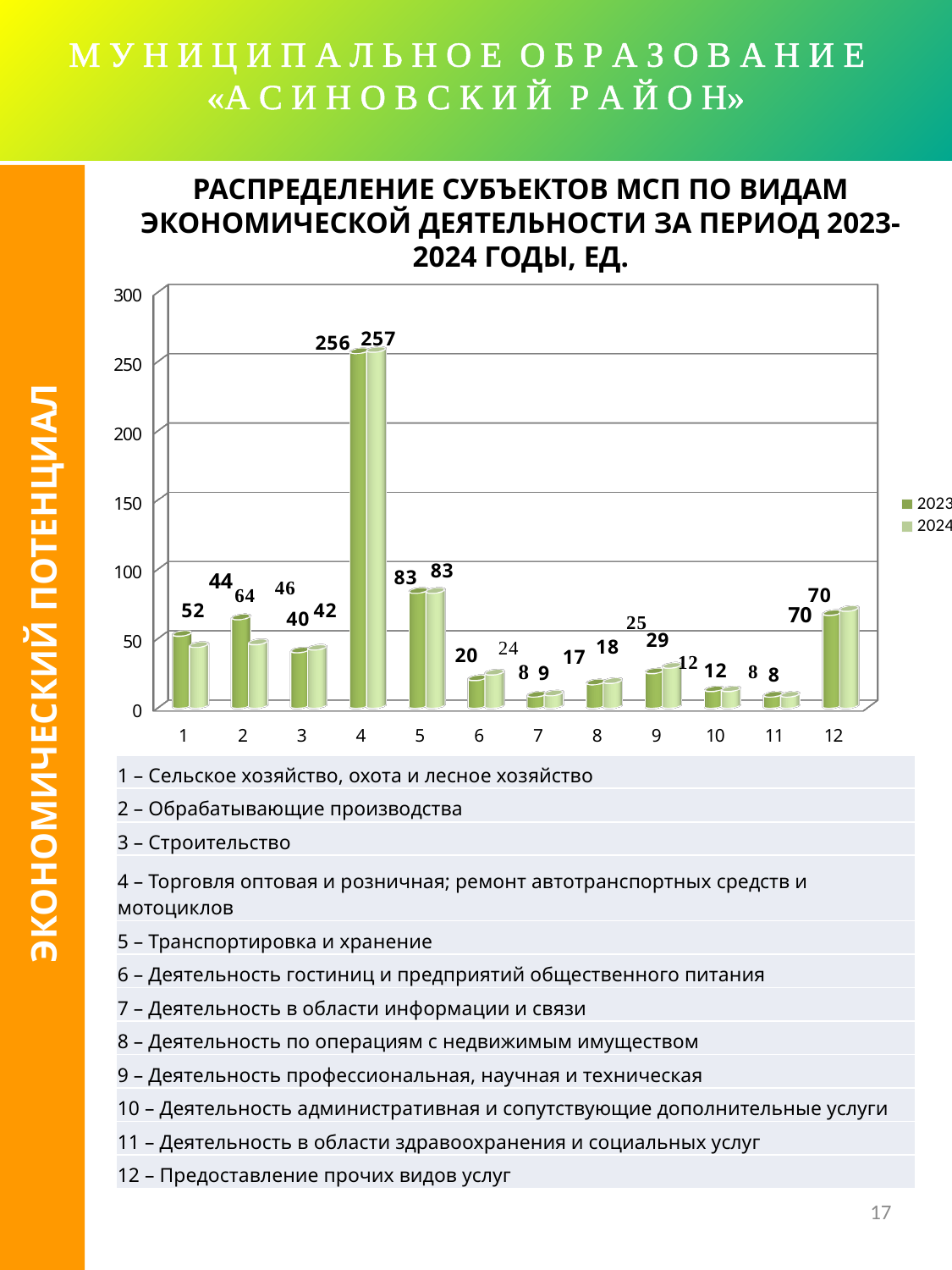
What is the value for category 5 in the 2024 series? 83 What is the difference between the 2024 and 2023 values for category 6? 4 What is the value for category 12 in the 2023 series? 70 What is the value for category 4 in the 2024 series? 257 Is the 2023 value for category 4 greater or less than 250? greater What kind of chart is shown on the slide? bar chart Which is larger in the 2023 series: the value for category 4 or the value for category 5? category 4 What is the value for category 6 in the 2024 series? 24 Which category has the highest value in the 2024 series? 4 What is the value for category 4 in the 2023 series? 256 How many series does the legend list? 2 How many categories are shown on the x axis of the chart? 12